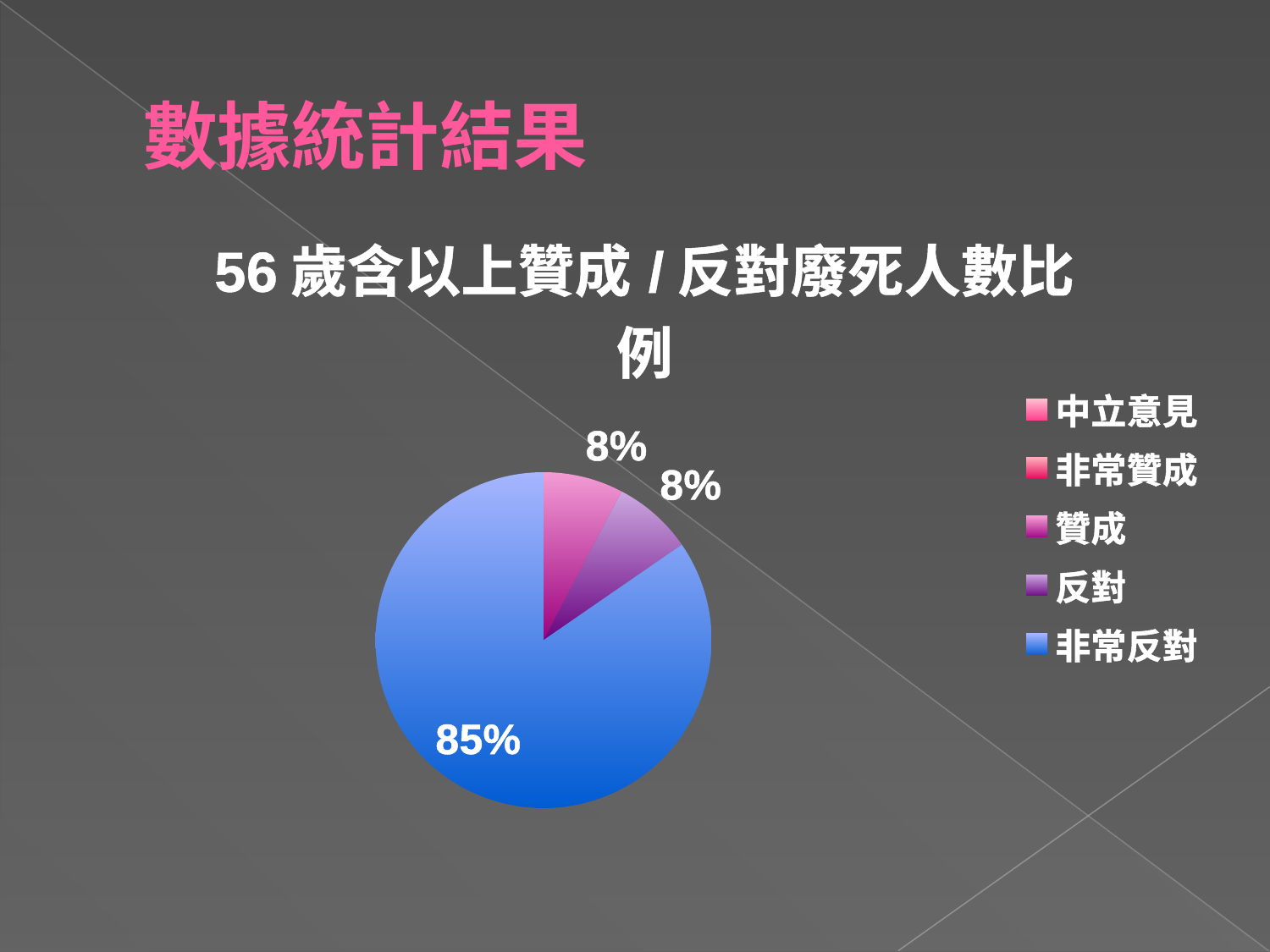
What share of the pie does the 非常反對 slice take? 85% Which category has the largest slice in the pie chart? 非常反對 What percentage is shown for 非常反對 in the pie chart? 85% What is the difference between the 85% slice and one of the 8% slices? 77% How many entries does the legend of the pie chart list? 5 What kind of chart is shown on the slide? pie chart What value is printed on the two smaller labelled slices of the pie chart? 8% What colour is the 非常反對 slice in the pie chart? blue Which is larger in the pie chart: the 非常反對 slice or either of the slices labelled 8%? 非常反對 How many slices in the pie chart carry a data label? 3 What is the title of the pie chart? 56 歲含以上贊成 / 反對廢死人數比例